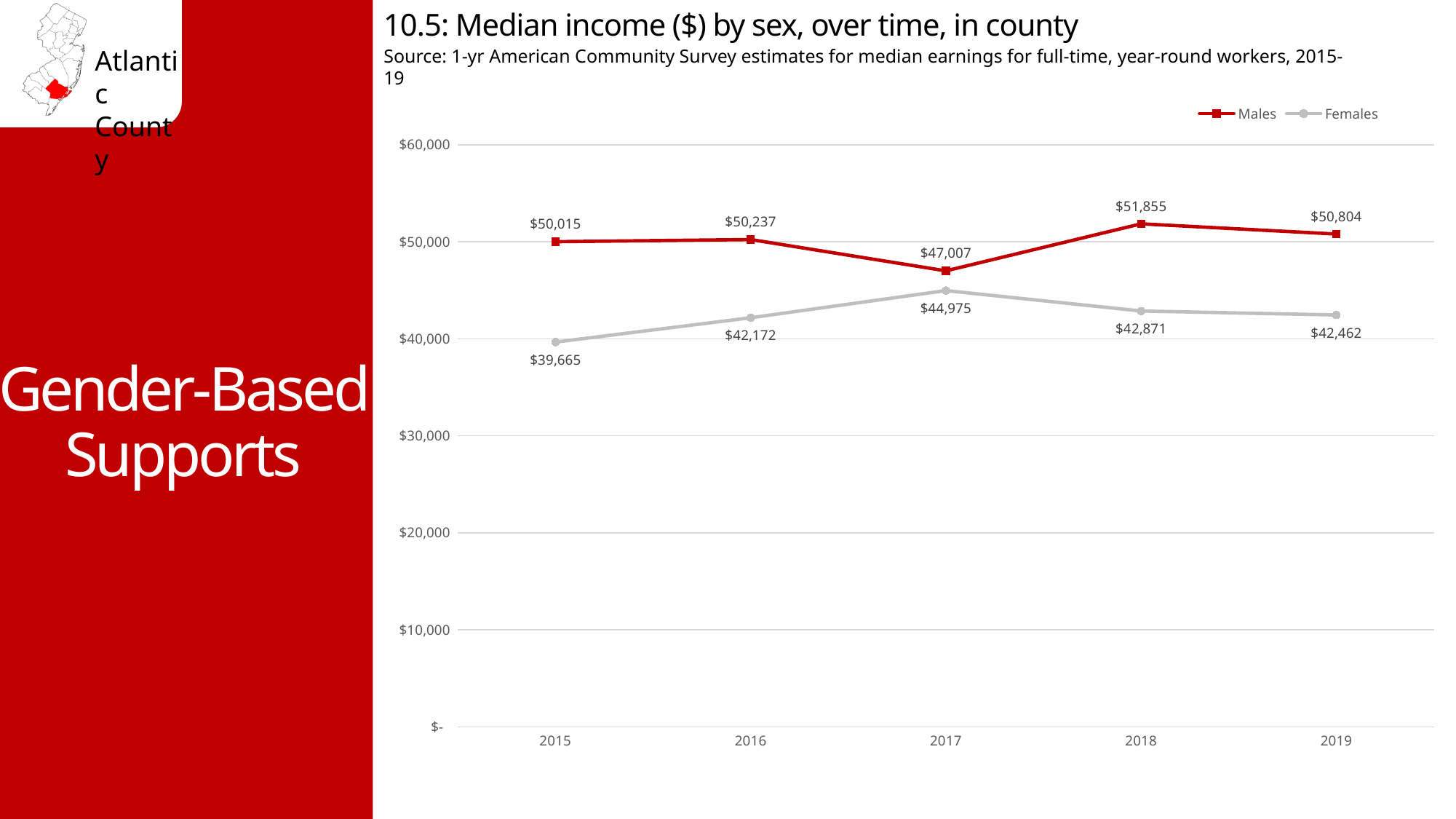
What was the median income for females in 2015? $39,665 In which year was the median income for females highest? 2017 In which year was the median income for females lowest? 2015 In which year was the median income for males highest? 2018 How many years are shown on the x axis? 5 How many series does the legend list? 2 What is the difference between the male and female median income in 2018? $8,984 What kind of chart is shown on the slide? Line chart What was the median income for females in 2019? $42,462 Which was larger in 2016, the median income for males or for females? Males What was the median income for males in 2017? $47,007 What is the difference between the male and female median income in 2017? $2,032